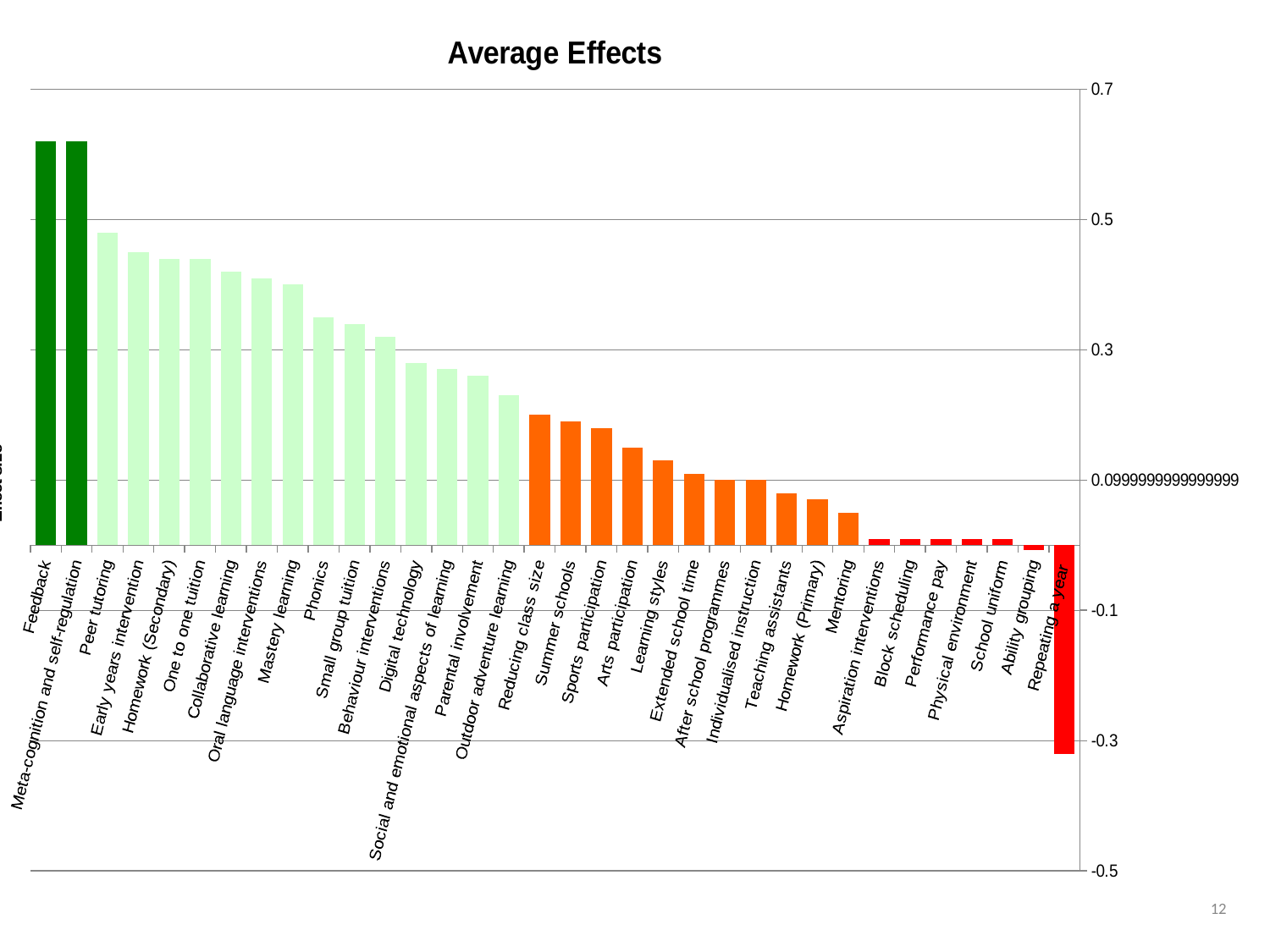
Which category has the lowest value in the chart? Repeating a year What kind of chart is shown on the slide? Bar chart How many categories are plotted in the chart? 34 Is the value for Feedback greater or less than 0.5? greater What is the title of the chart? Average Effects Is the value for Mastery learning greater or less than 0.3? greater Is the value for Mentoring greater or less than 0.1? less Which has the larger value, Phonics or Mentoring? Phonics What colour is the bar for Repeating a year? Red Do the values generally rise or fall moving from left to right along the x axis? Fall